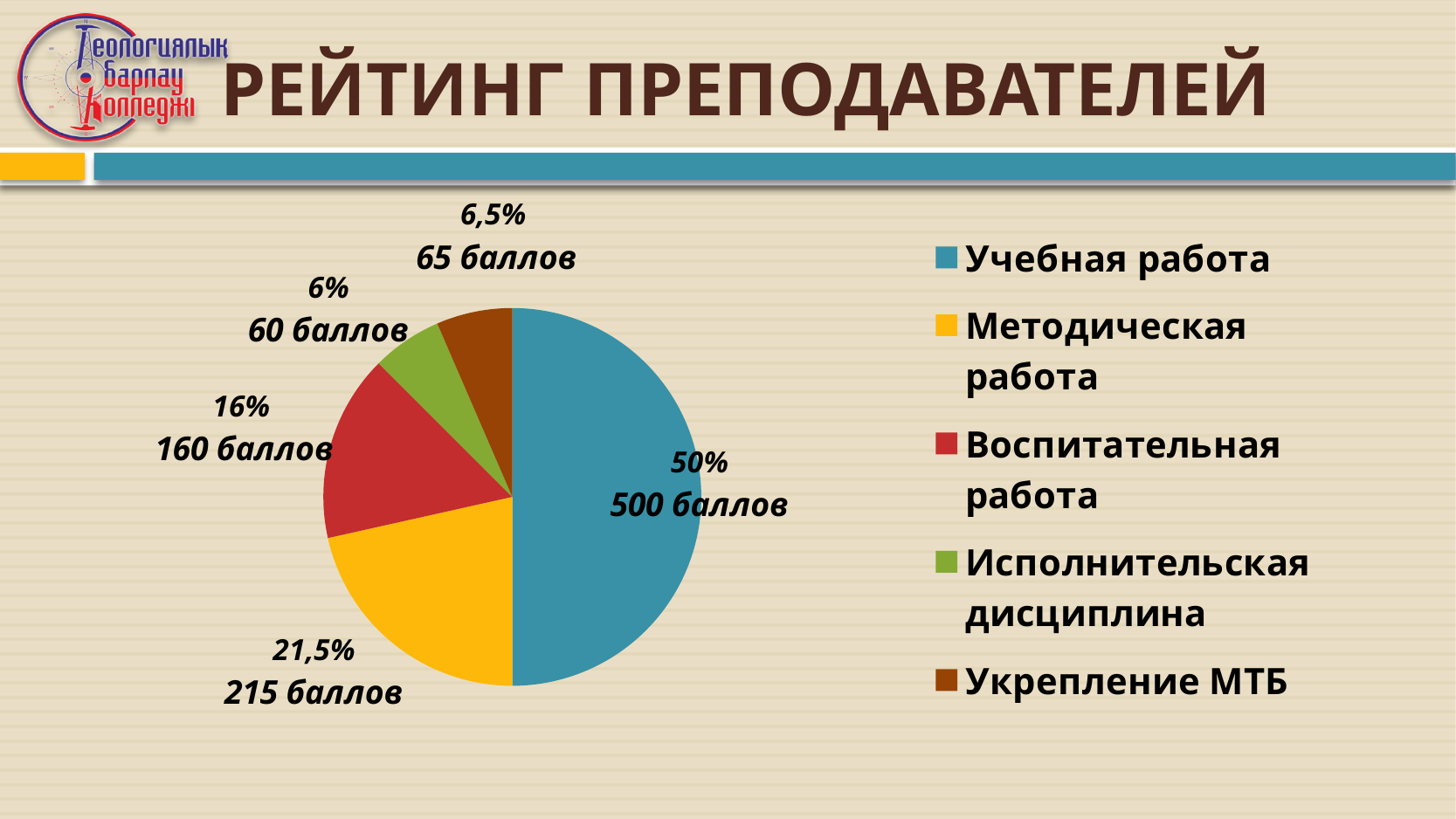
Which category has the largest slice of the pie? Учебная работа Which colour represents Воспитательная работа in the legend? Red What is the difference in баллов between Учебная работа and Методическая работа? 285 баллов How many slices does the pie chart have? 5 How many баллов are shown for Методическая работа? 215 баллов How many баллов are shown for Воспитательная работа? 160 баллов What share of the pie does Учебная работа take? 50% What is the title of the slide above the chart? РЕЙТИНГ ПРЕПОДАВАТЕЛЕЙ What kind of chart is shown on the slide? Pie chart What percentage is shown for Укрепление МТБ? 6,5% How many entries does the legend list? 5 Which category has the smallest slice of the pie? Исполнительская дисциплина